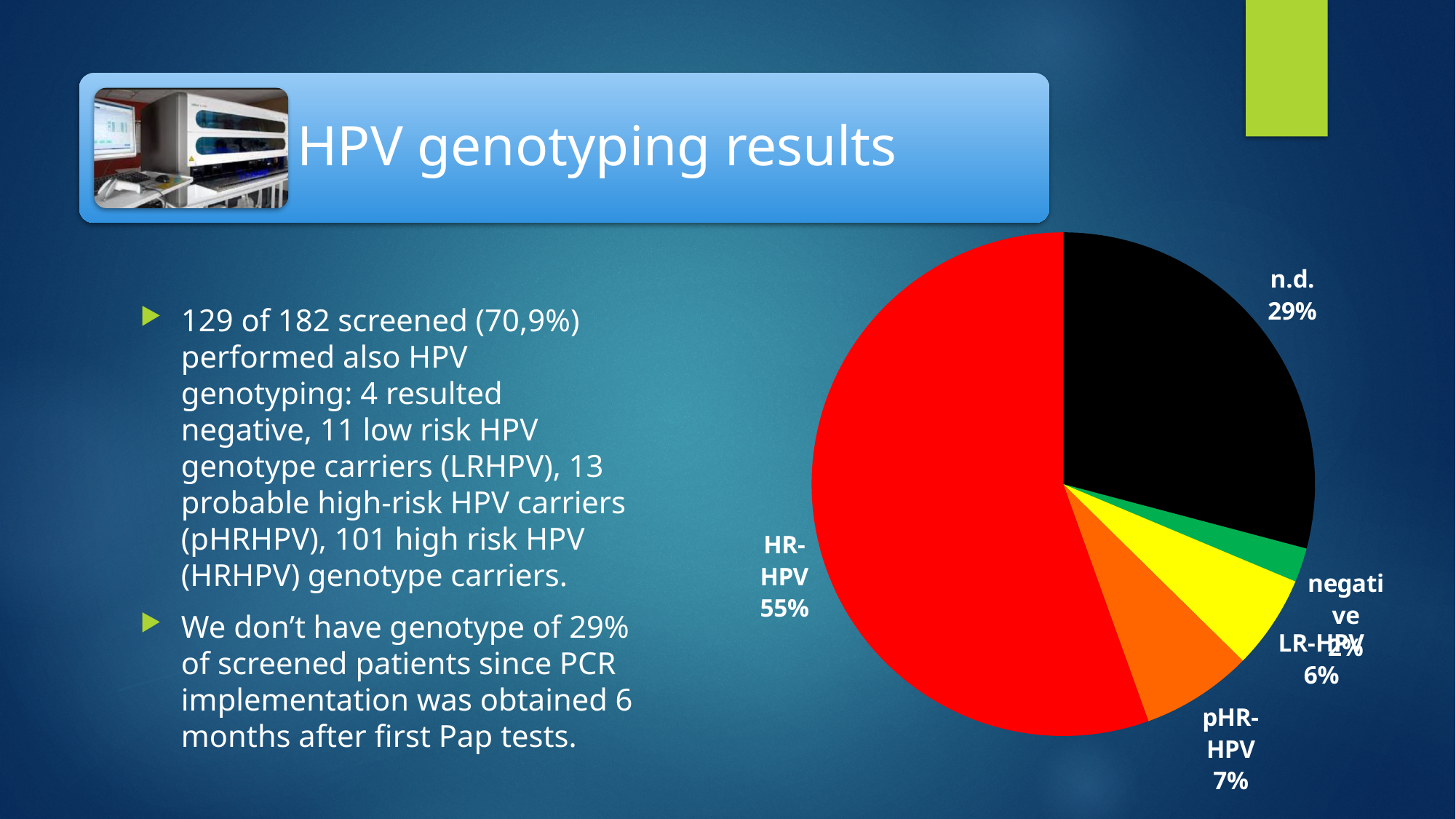
What colour is the HR-HPV slice? red What colour is the n.d. slice? black Which is larger, the pHR-HPV slice or the LR-HPV slice? pHR-HPV How many slices does the pie chart have? 5 What kind of chart is shown on the slide? pie chart What is the difference in percentage points between HR-HPV and n.d.? 26 What percentage is shown for LR-HPV? 6% What share of the pie does HR-HPV represent? 55% What percentage is shown for the n.d. slice? 29% Which slice of the pie is the largest? HR-HPV Which slice of the pie is the smallest? negative What percentage is shown for pHR-HPV? 7%